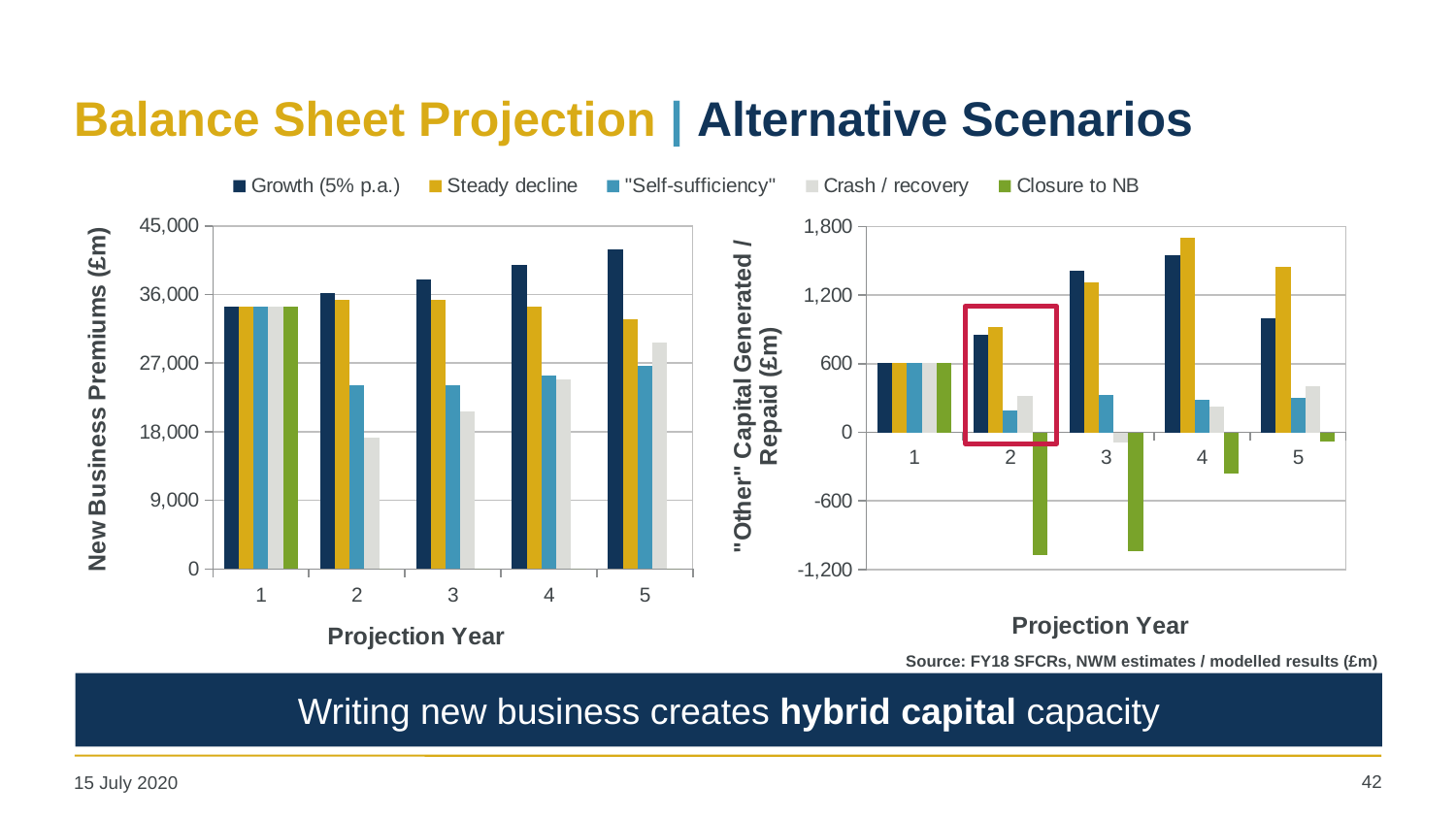
In the left chart (New Business Premiums), is the value for "Self-sufficiency" in projection year 2 greater or less than 27,000? less In the right chart ("Other" Capital Generated / Repaid), which series has the highest value in projection year 4? Steady decline In the left chart (New Business Premiums), is the value for Growth (5% p.a.) in projection year 5 greater or less than 36,000? greater In the left chart (New Business Premiums), how many projection years are shown on the x axis? 5 In the right chart ("Other" Capital Generated / Repaid), which projection year is highlighted with a red box? 2 In the left chart (New Business Premiums), do the Steady decline values rise or fall from projection year 1 to year 5? fall In the right chart ("Other" Capital Generated / Repaid), is the value for Growth (5% p.a.) in projection year 3 greater or less than 1,200? greater In the left chart (New Business Premiums), which series has the highest value in projection year 5? Growth (5% p.a.) How many series does the legend list? 5 In the left chart (New Business Premiums), do the Growth (5% p.a.) values rise or fall from projection year 1 to year 5? rise In the right chart ("Other" Capital Generated / Repaid), which series has the lowest value in projection year 2? Closure to NB What kind of chart is the left chart (New Business Premiums)? bar chart